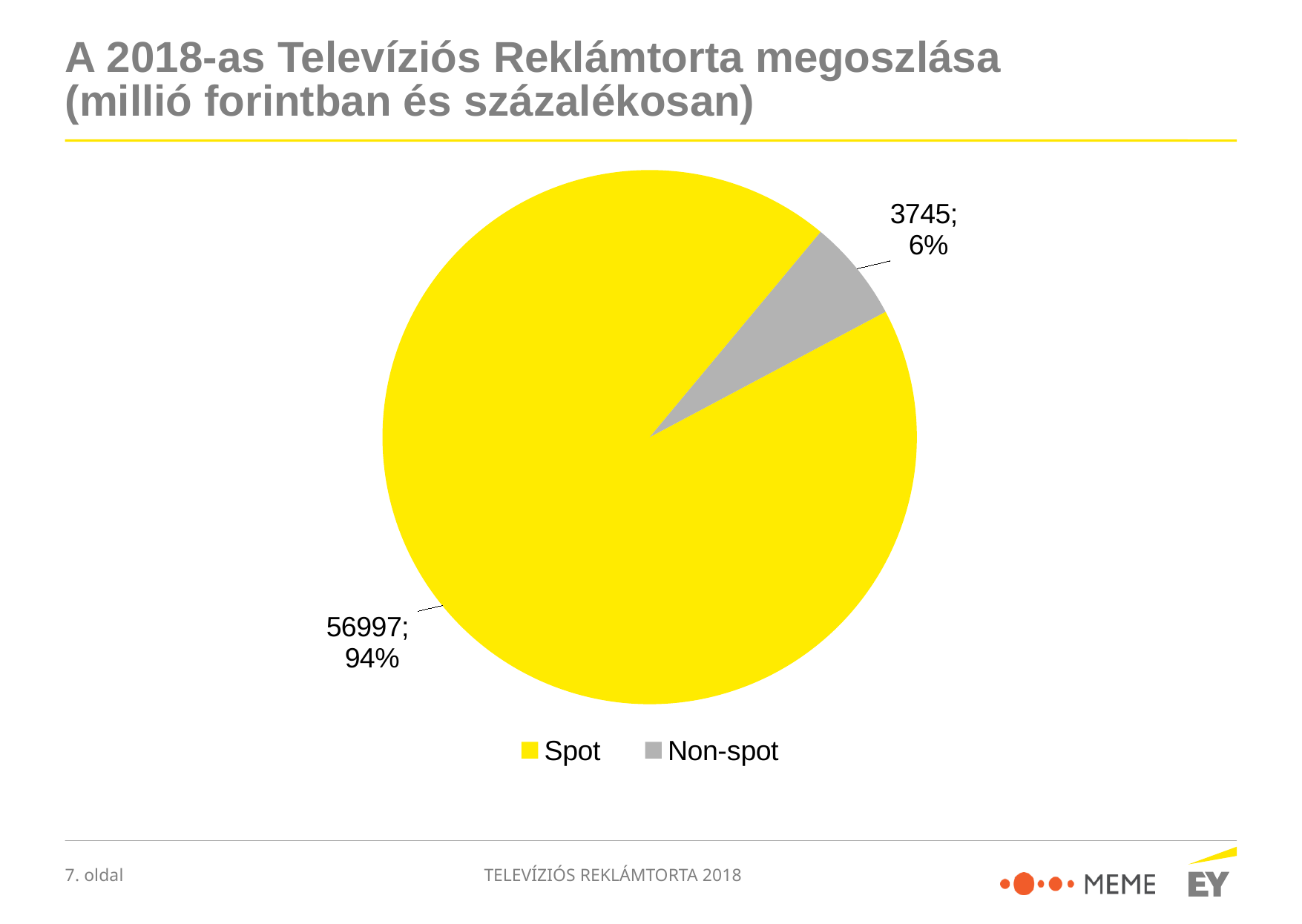
How many slices does the pie chart have? 2 Which category has the smallest slice? Non-spot What is the difference between the Spot and Non-spot values? 53252 What share of the pie does Spot represent? 94% Which is larger, Spot or Non-spot? Spot How many entries does the legend list? 2 Which category has the largest slice? Spot What is the value for Non-spot? 3745 What is the value for Spot? 56997 What share of the pie does Non-spot represent? 6% What type of chart is shown on the slide? pie chart What colour is the Non-spot slice? grey